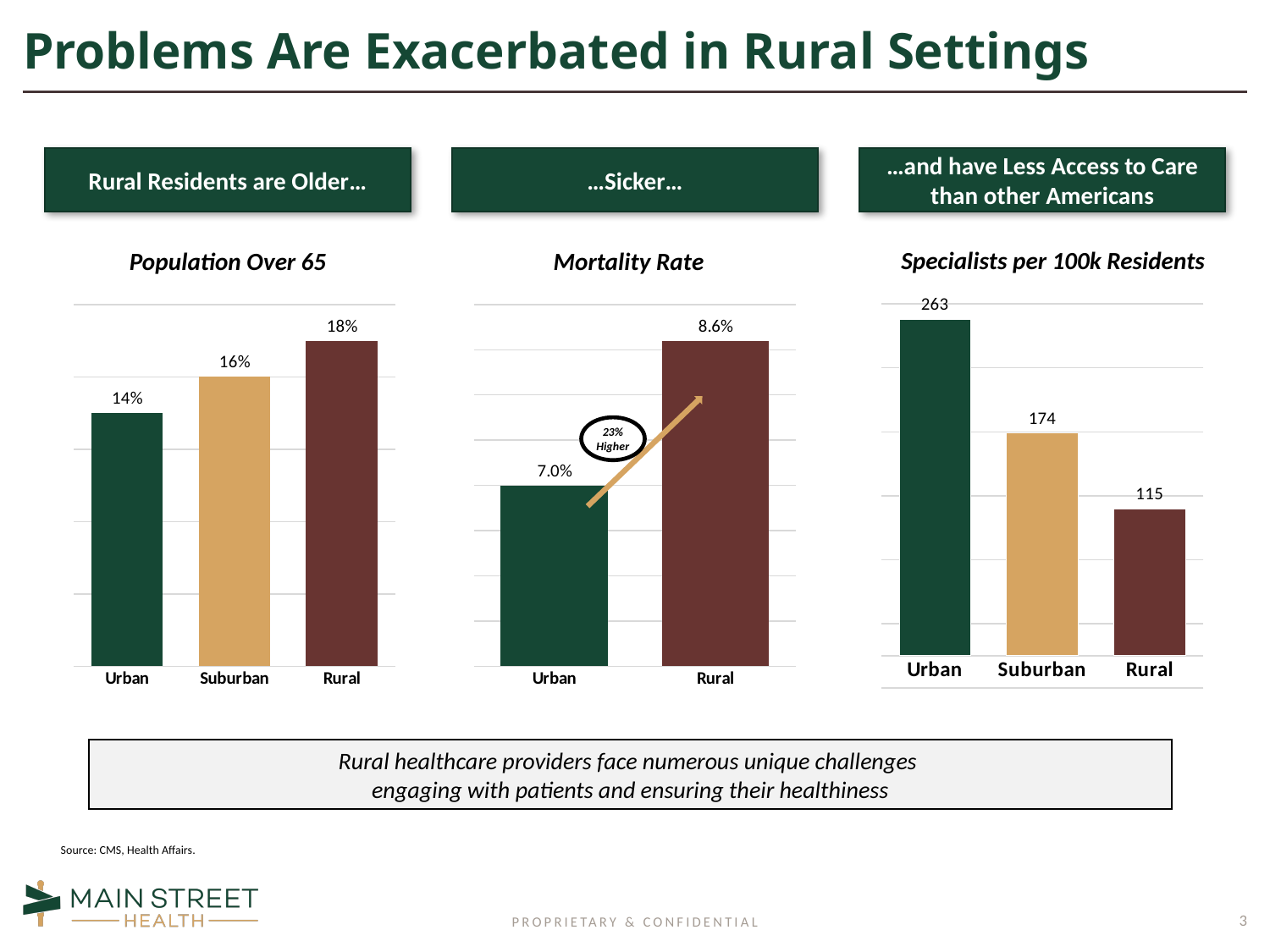
In the Population Over 65 chart, what is the value for Rural? 18% In the Population Over 65 chart, what is the value for Urban? 14% In the Mortality Rate chart, how many categories are plotted? 2 In the Mortality Rate chart, what is the value for Rural? 8.6% In the Specialists per 100k Residents chart, do the values rise or fall from Urban to Rural? fall In the Mortality Rate chart, what is the difference between the Rural and Urban values? 1.6% In the Specialists per 100k Residents chart, what is the value for Suburban? 174 In the Population Over 65 chart, what is the difference between the Rural and Suburban values? 2% In the Population Over 65 chart, which category has the lowest value? Urban What kind of chart is the Mortality Rate chart? bar chart In the Specialists per 100k Residents chart, what is the difference between the Urban and Rural values? 148 In the Specialists per 100k Residents chart, which category has the highest value? Urban